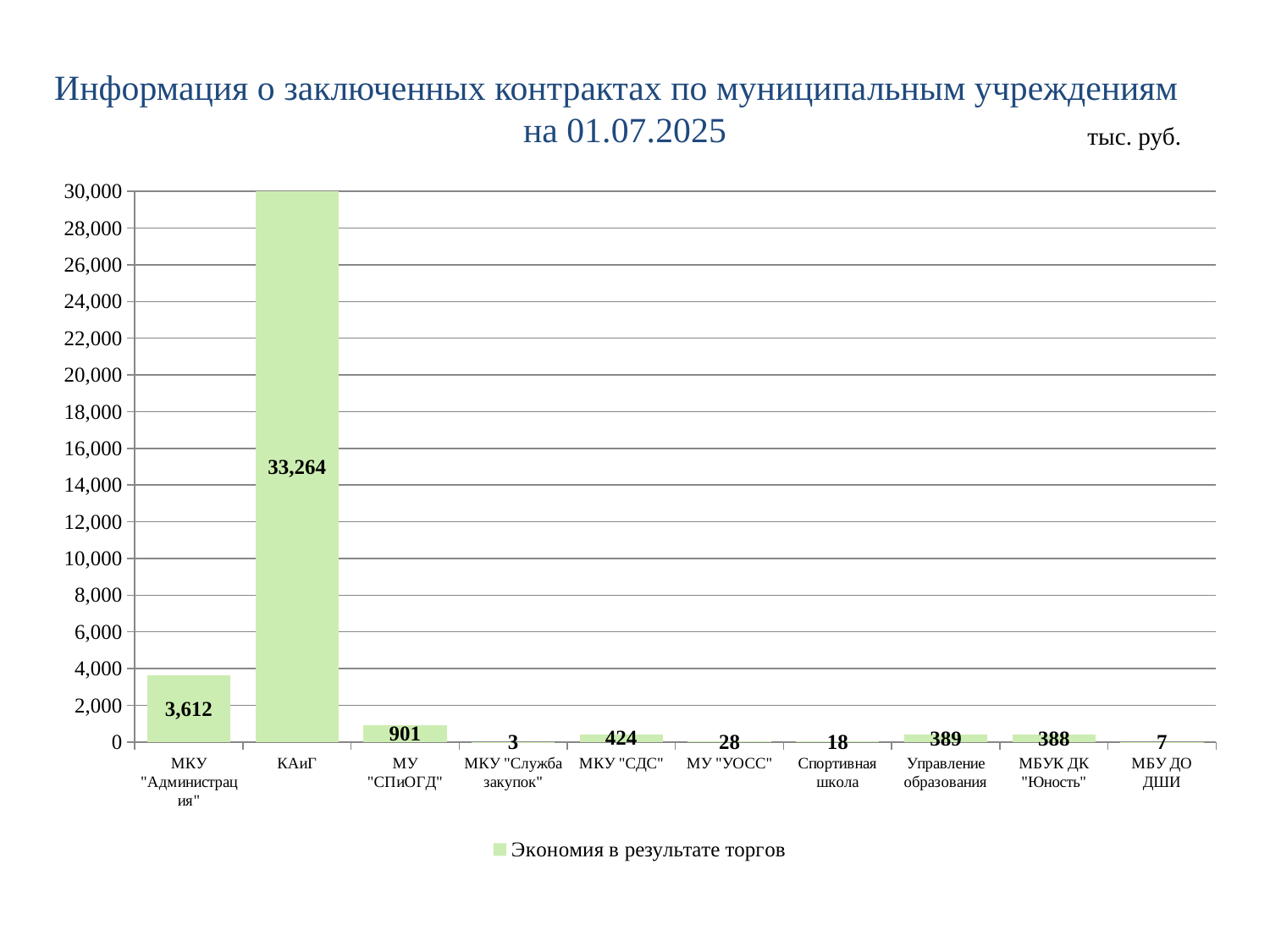
How many categories are shown on the x axis? 10 Which category has the highest value? КАиГ Is the value for МКУ "Администрация" greater or less than 2,000? greater What kind of chart is shown on the slide? bar chart What is the value for Управление образования? 389 What is the value for МКУ "Администрация"? 3,612 Which category has the lowest value? МКУ "Служба закупок" What is the value for КАиГ? 33,264 What is the value for МУ "СПиОГД"? 901 How many series does the legend list? 1 What is the difference between the values for КАиГ and МКУ "Администрация"? 29,652 Which is larger, the value for МКУ "СДС" or the value for МУ "УОСС"? МКУ "СДС"